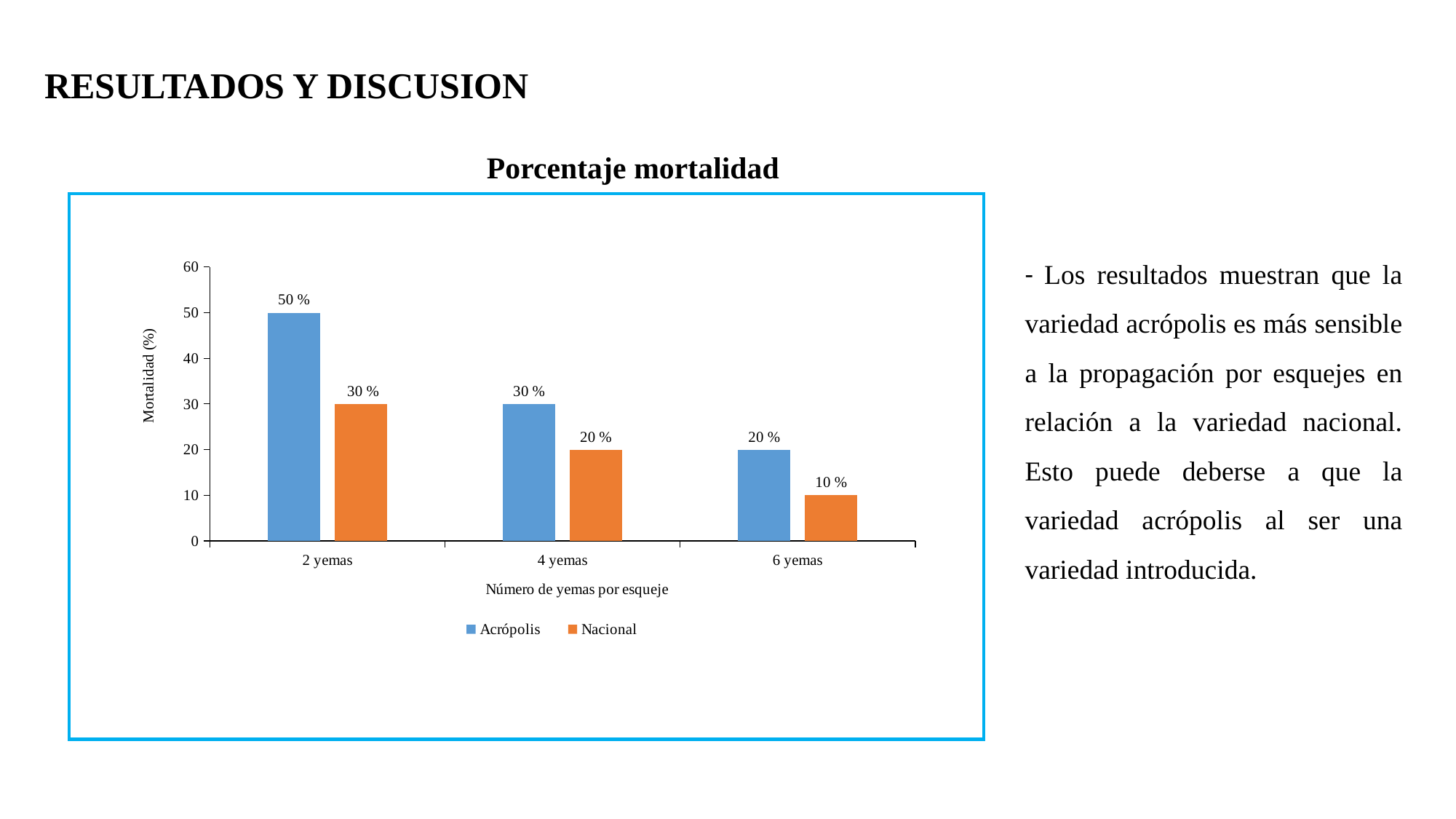
What kind of chart is shown on the slide? Bar chart At 6 yemas, which series has the larger mortality value, Acrópolis or Nacional? Acrópolis What is the mortality value for Nacional at 4 yemas? 20 % Which category has the highest Acrópolis mortality? 2 yemas How many series does the legend list? 2 What is the difference between the Acrópolis and Nacional values at 2 yemas? 20 % What is the mortality value for Nacional at 6 yemas? 10 % Do the Acrópolis values rise or fall as the number of yemas increases? Fall Which category has the lowest Nacional mortality? 6 yemas How many categories are shown on the x axis? 3 What is the title of the chart? Porcentaje mortalidad What is the mortality value for Acrópolis at 2 yemas? 50 %